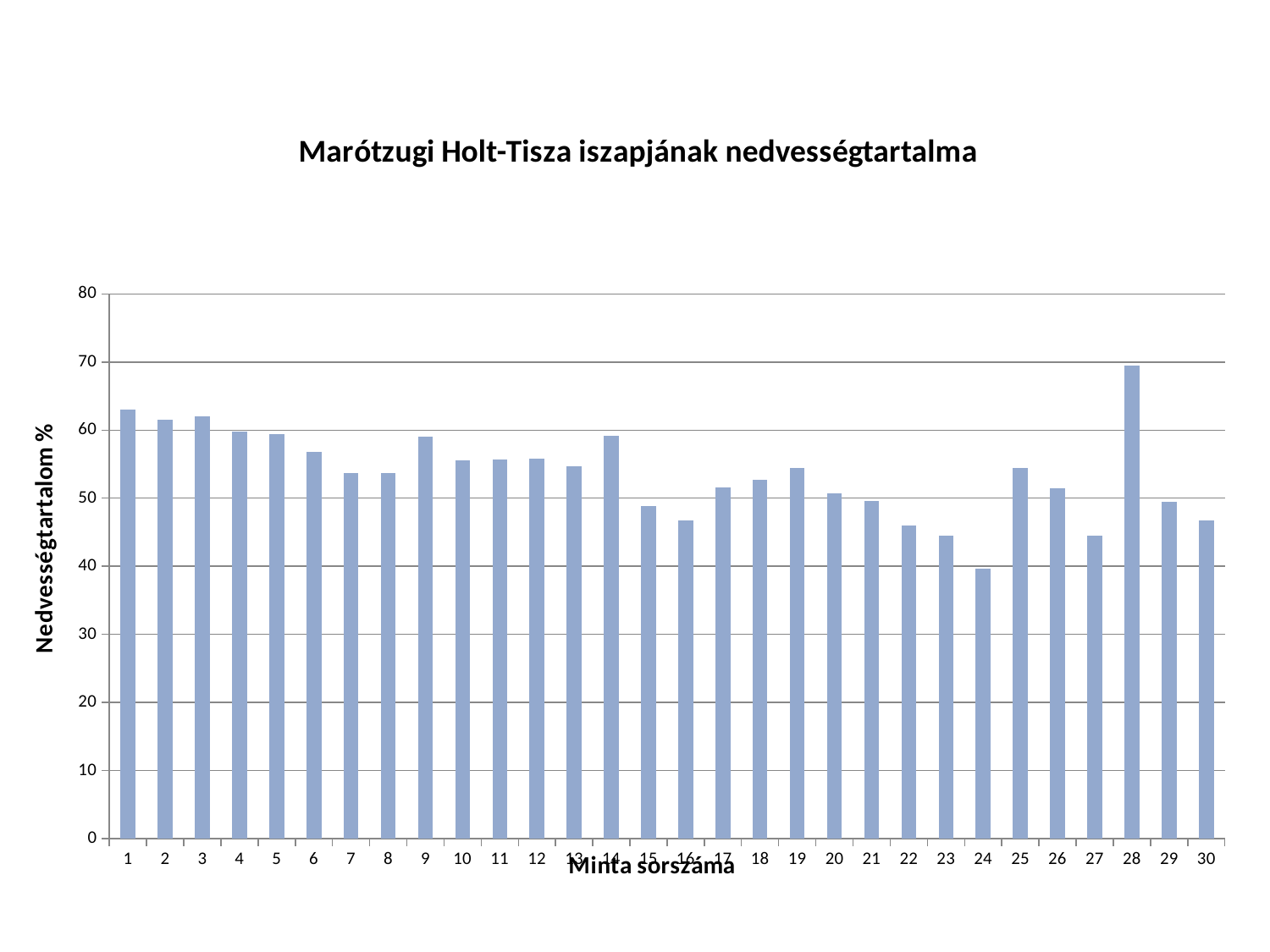
Is the value for sample 23 greater or less than 50? less Is the value for sample 1 greater or less than 60? greater Is the value for sample 16 greater or less than 50? less How many samples (bars) are plotted on the chart? 30 What type of chart is shown on the slide? bar chart What is the title of the chart? Marótzugi Holt-Tisza iszapjának nedvességtartalma Which sample number has the lowest moisture content? 24 Which sample number has the highest moisture content? 28 Which has a higher moisture content, sample 15 or sample 19? sample 19 Which has a higher moisture content, sample 28 or sample 3? sample 28 What is the label of the vertical axis? Nedvességtartalom %